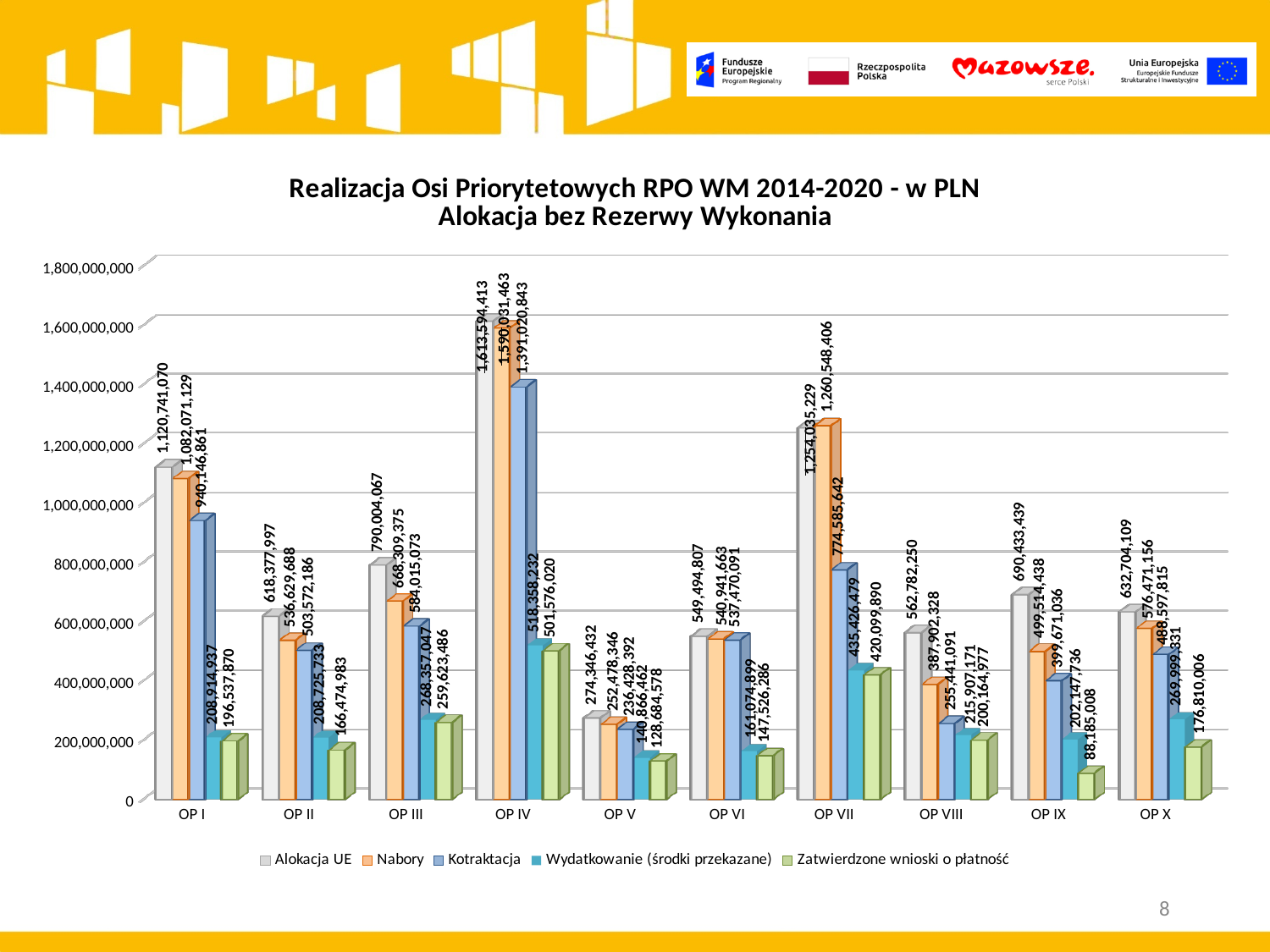
What is the difference between the Alokacja UE and Nabory values for OP VIII? 174,879,922 What kind of chart is shown on the slide? bar chart What is the Zatwierdzone wnioski o płatność value for OP IX? 88,185,008 Which has the larger Kotraktacja value, OP III or OP X? OP III How many priority axes (categories) are shown on the x axis? 10 Which priority axis has the lowest Alokacja UE value? OP V What is the Alokacja UE value for OP IV? 1,613,594,413 What is the Wydatkowanie (środki przekazane) value for OP VII? 435,426,479 Is the Alokacja UE value for OP IX greater or less than 600,000,000? greater Which priority axis has the highest Alokacja UE value? OP IV How many series does the legend list? 5 What is the title of the chart? Realizacja Osi Priorytetowych RPO WM 2014-2020 - w PLN Alokacja bez Rezerwy Wykonania